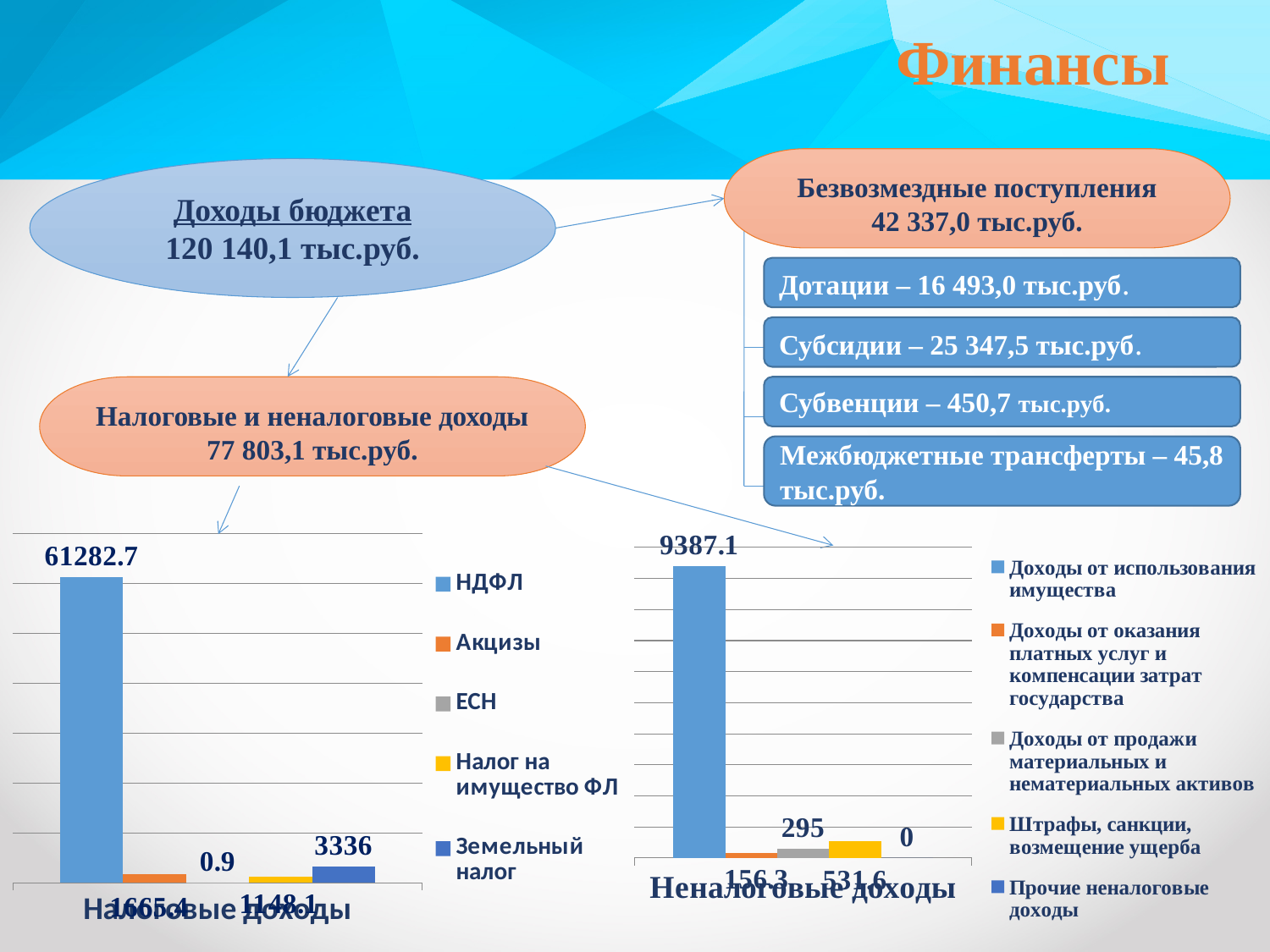
In the 'Налоговые доходы' chart, which series has the lowest value? ЕСН In the 'Налоговые доходы' chart, which series has the highest value? НДФЛ In the 'Неналоговые доходы' chart, what is the value for Прочие неналоговые доходы? 0 In the 'Неналоговые доходы' chart, which is larger: Доходы от продажи материальных и нематериальных активов or Штрафы, санкции, возмещение ущерба? Штрафы, санкции, возмещение ущерба In the 'Неналоговые доходы' chart, what is the value for Доходы от использования имущества? 9387.1 What kind of chart is the 'Налоговые доходы' chart? bar chart In the 'Налоговые доходы' chart, what is the value for ЕСН? 0.9 In the 'Налоговые доходы' chart, how many series does the legend list? 5 In the 'Налоговые доходы' chart, what is the value for НДФЛ? 61282.7 In the 'Неналоговые доходы' chart, what is the value for Штрафы, санкции, возмещение ущерба? 531.6 In the 'Налоговые доходы' chart, what is the value for Земельный налог? 3336